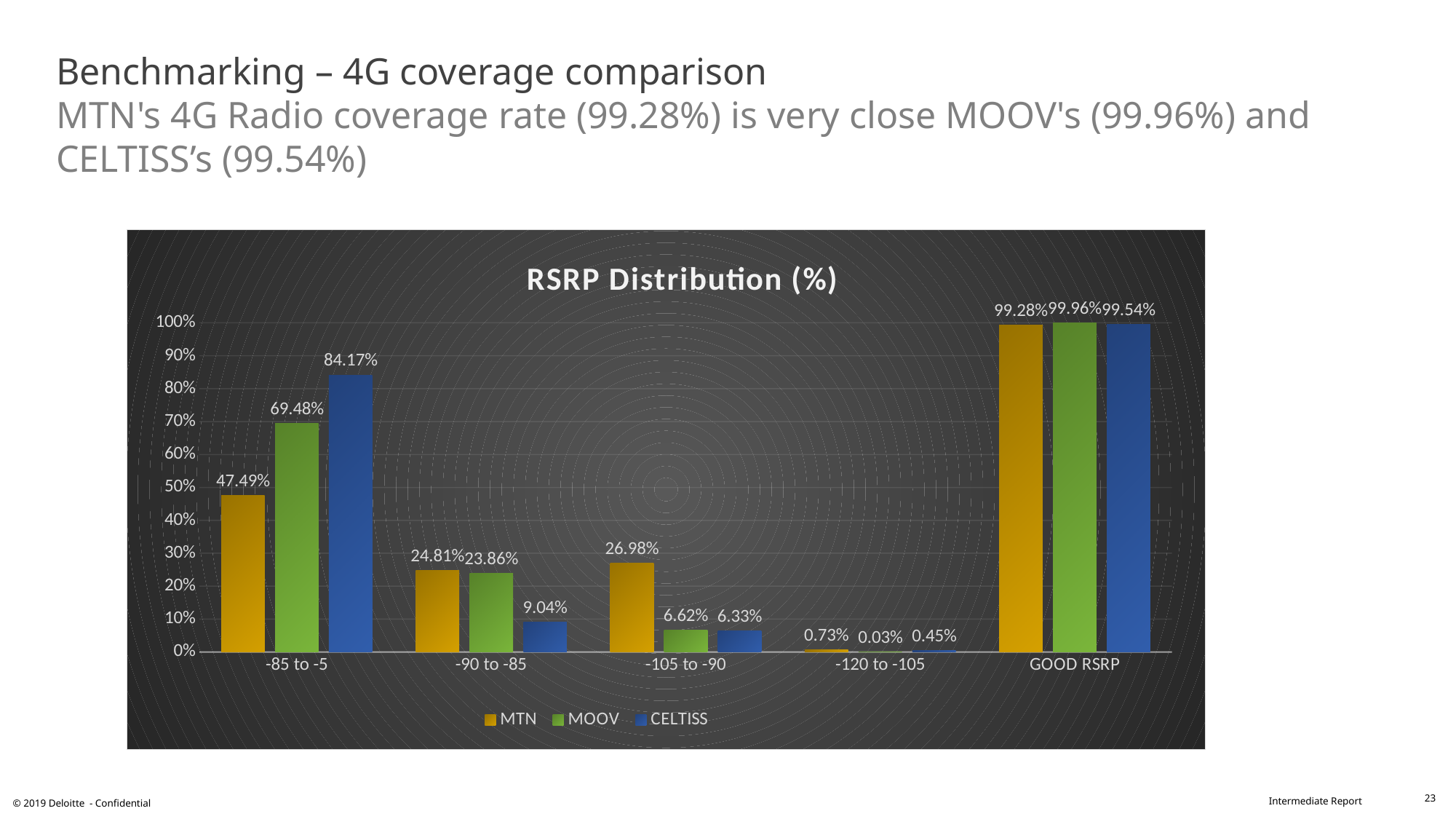
What is the value for MOOV in the -90 to -85 category? 23.86% What type of chart is shown on the slide? Bar chart What is the difference between the CELTISS and MTN values in the -85 to -5 category? 36.68% What is the value for MTN in the -85 to -5 category? 47.49% How many series does the legend list? 3 What is the value for MOOV in the -120 to -105 category? 0.03% Which is larger in the -90 to -85 category: MTN or CELTISS? MTN What is the value for MTN in the -105 to -90 category? 26.98% Which operator has the highest value in the -85 to -5 category? CELTISS What is the value for CELTISS in the -85 to -5 category? 84.17% Which operator has the lowest value in the -105 to -90 category? CELTISS How many categories are shown on the x axis? 5